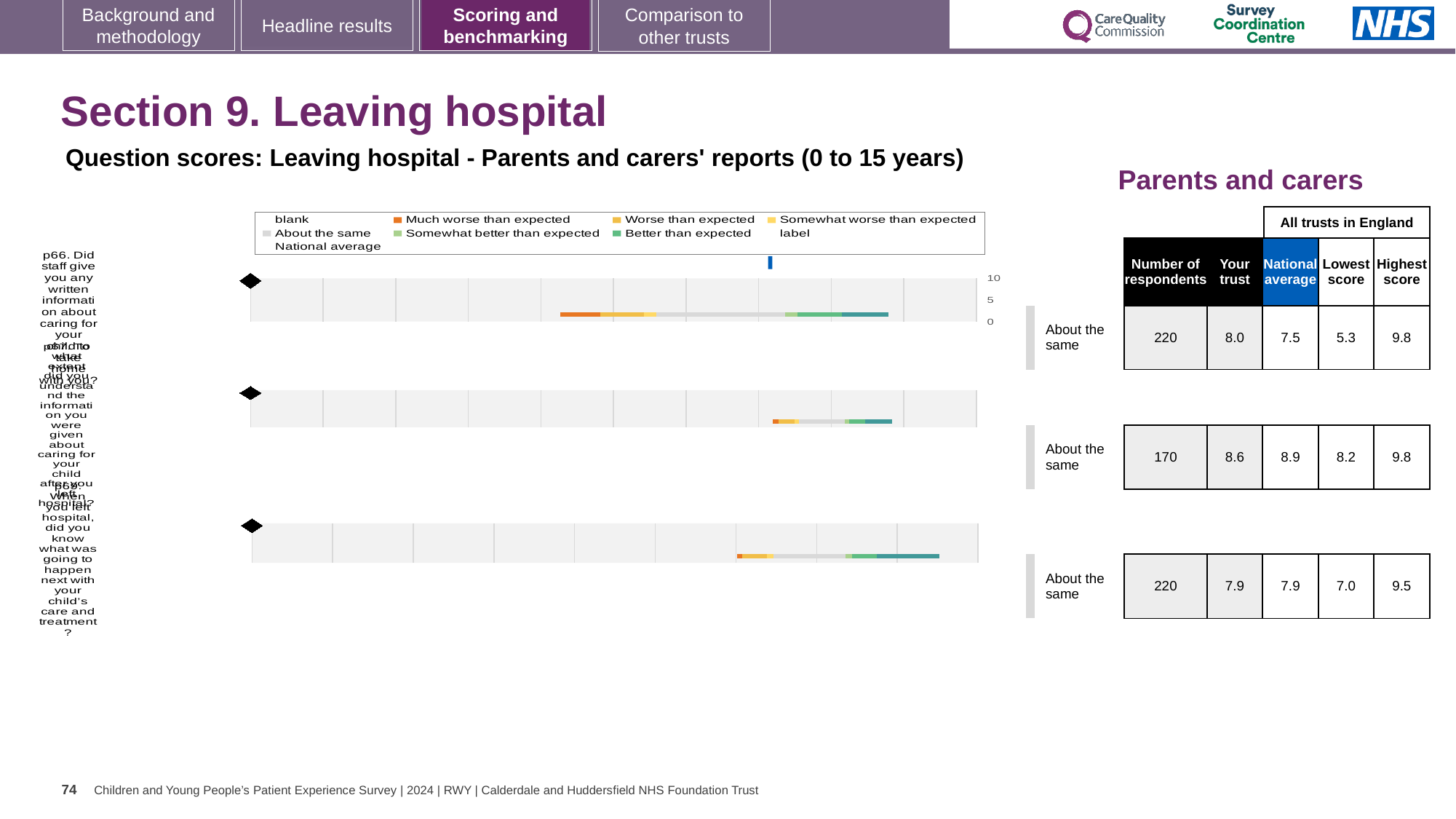
For the top chart (p66), what is the national average score? 7.5 How many question score charts are shown on the slide? 3 For the bottom chart (p68), what is the difference between the highest score and the lowest score? 2.5 What kind of chart is used to show the question scores on this slide? bar chart For the middle chart, what is the number of respondents? 170 What benchmark category is shown next to each of the three charts? About the same Which of the three charts has the lowest 'Lowest score' value in the table? Top chart (p66) For the middle chart, is the 'Your trust' score or the national average higher? National average For the bottom chart (p68), what is the highest score across all trusts in England? 9.5 For the top chart (p66), what is the 'Your trust' score shown in the table? 8.0 In the chart legend, which colour category is listed first after 'blank'? Much worse than expected In the chart legend, what label is shown in green for the best category? Better than expected